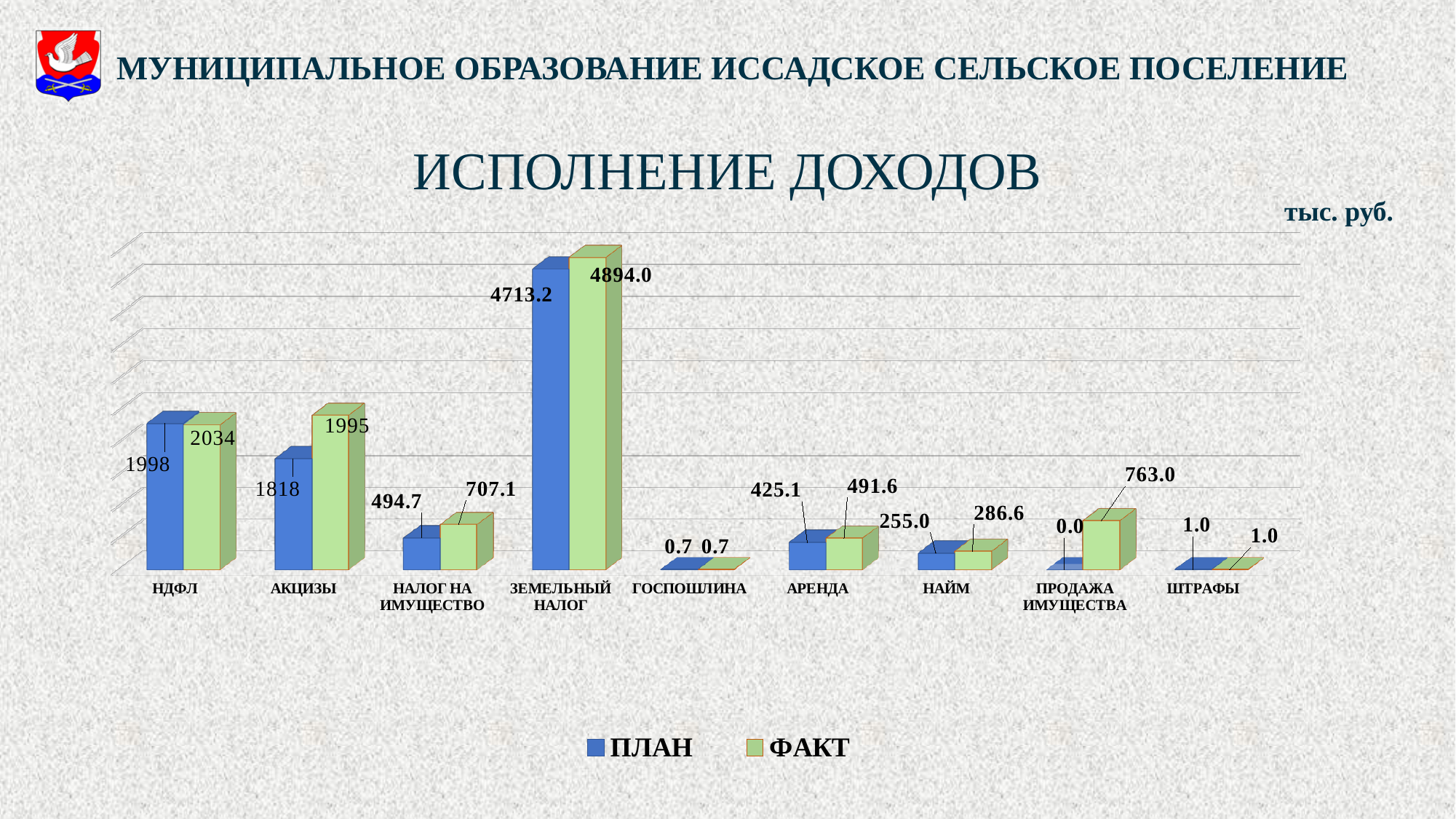
What is the difference between the ФАКТ and ПЛАН values for АКЦИЗЫ? 177 What is the ФАКТ value for ПРОДАЖА ИМУЩЕСТВА? 763.0 What is the difference between the ФАКТ and ПЛАН values for НАЙМ? 31.6 What is the ПЛАН value for АРЕНДА? 425.1 How many series does the legend list? 2 What is the ФАКТ value for НАЛОГ НА ИМУЩЕСТВО? 707.1 Which category has the lowest ПЛАН value? ПРОДАЖА ИМУЩЕСТВА What kind of chart is shown on the slide? Bar chart Which category has the highest ФАКТ value? ЗЕМЕЛЬНЫЙ НАЛОГ What is the ПЛАН value for ЗЕМЕЛЬНЫЙ НАЛОГ? 4713.2 Which is larger for НДФЛ, the ПЛАН value or the ФАКТ value? ФАКТ How many categories are shown on the x axis? 9